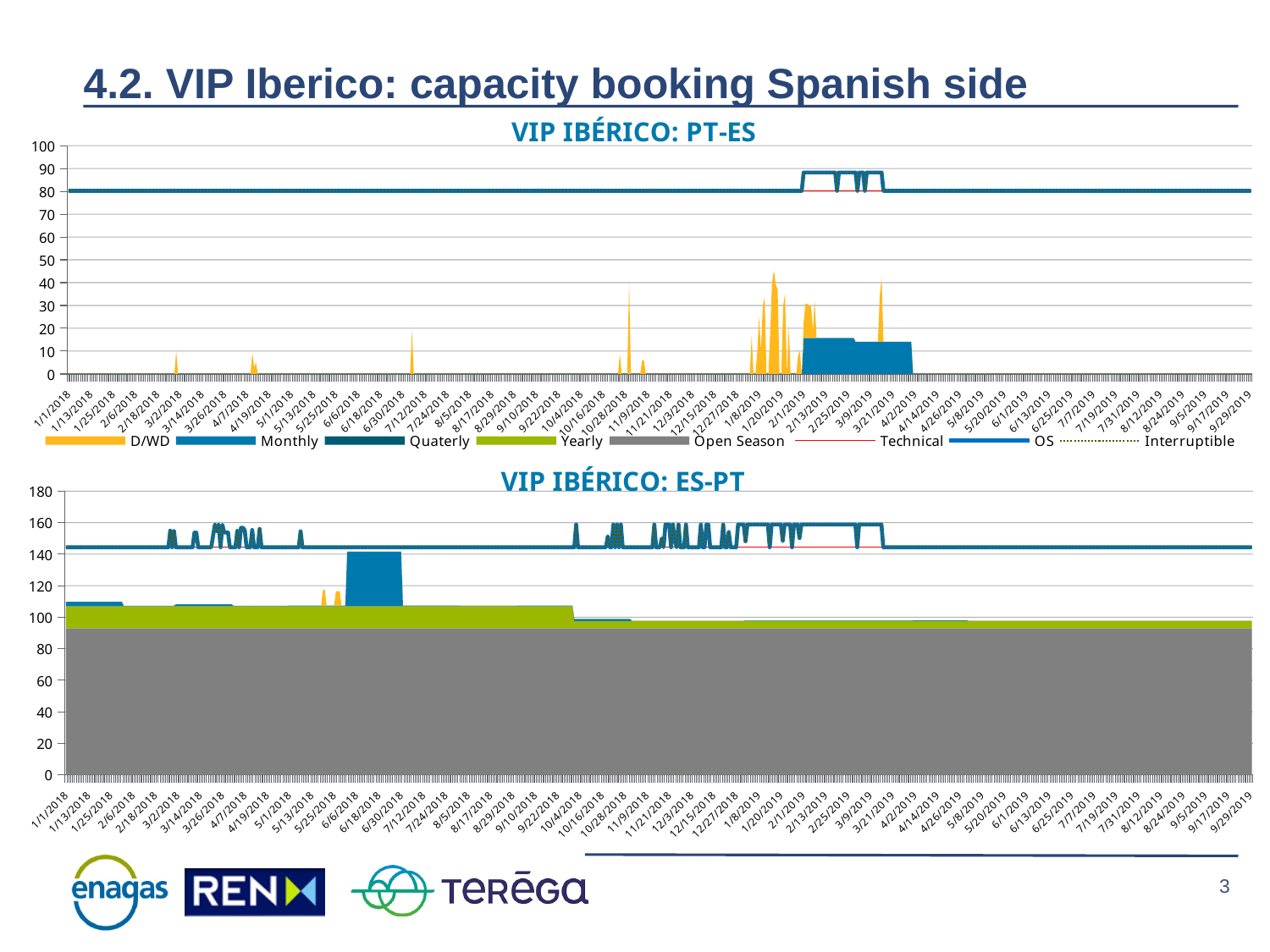
In the VIP IBÉRICO: PT-ES chart, is the highest D/WD peak in January 2019 greater or less than 50? less In the VIP IBÉRICO: ES-PT chart, is the Technical line on 1/1/2018 greater or less than 140? greater In the VIP IBÉRICO: ES-PT chart, is the top of the grey Open Season area on 1/1/2018 greater or less than 80? greater In the VIP IBÉRICO: ES-PT chart, on 1/1/2018, which is higher: the Technical line or the top of the stacked area? Technical line How many charts are shown on the slide? 2 What is the title of the lower chart on the slide? VIP IBÉRICO: ES-PT What kind of chart is the VIP IBÉRICO: PT-ES chart? Area chart How many series does the legend of the VIP IBÉRICO: PT-ES chart list? 8